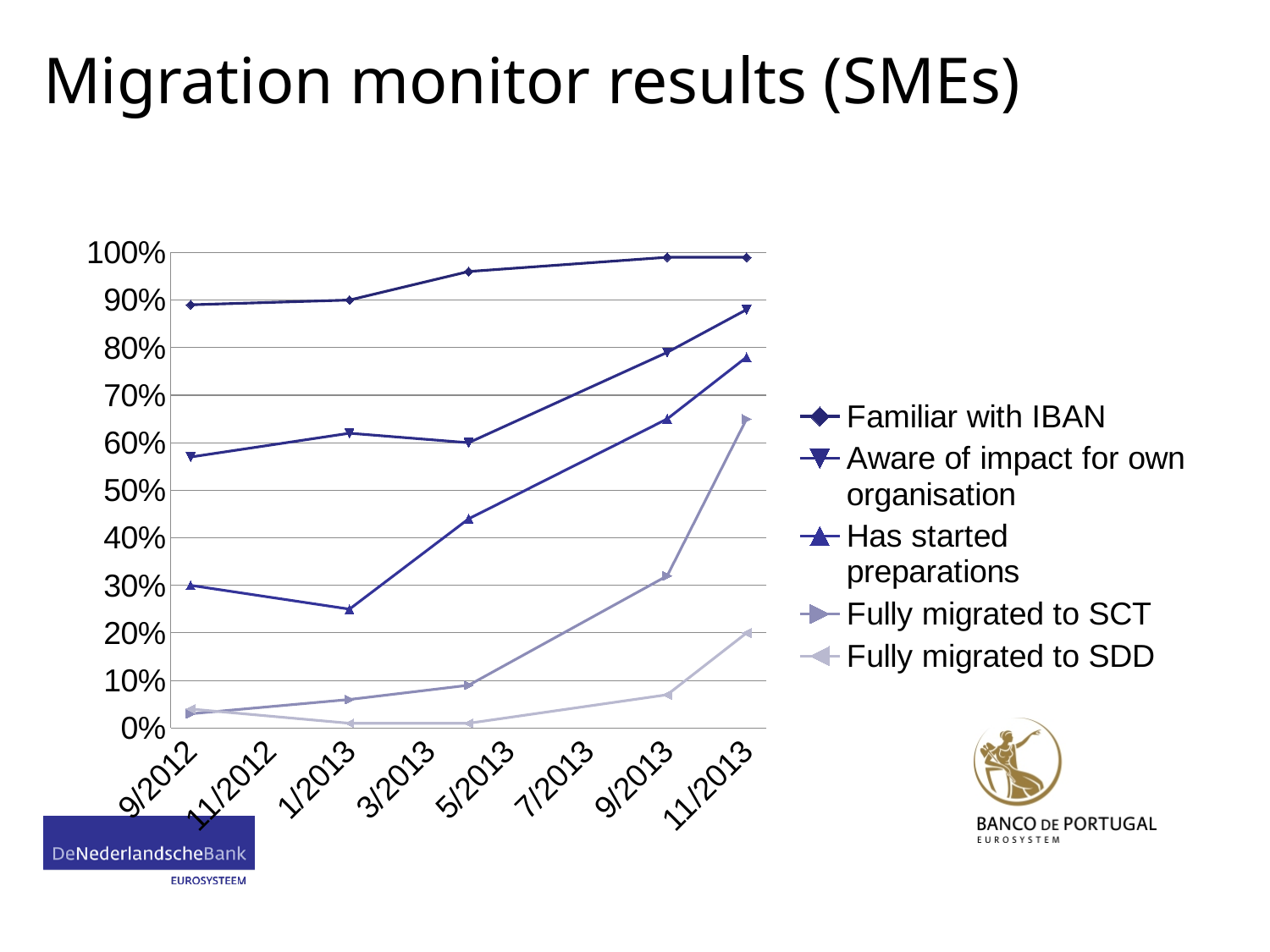
What kind of chart is shown on the slide? line chart Does the Fully migrated to SCT series rise or fall from 9/2012 to 11/2013? rise How many series does the legend list? 5 At 11/2013, which is larger: Fully migrated to SCT or Fully migrated to SDD? Fully migrated to SCT Is the value for Familiar with IBAN at 9/2012 greater or less than 80%? greater Is the value for Aware of impact for own organisation at 11/2013 greater or less than 80%? greater Is the value for Has started preparations at 1/2013 greater or less than 30%? less What is the title of the slide containing the chart? Migration monitor results (SMEs) Which series has the lowest value at 11/2013? Fully migrated to SDD Which series has the highest value at 9/2012? Familiar with IBAN How many date labels are shown along the x axis? 8